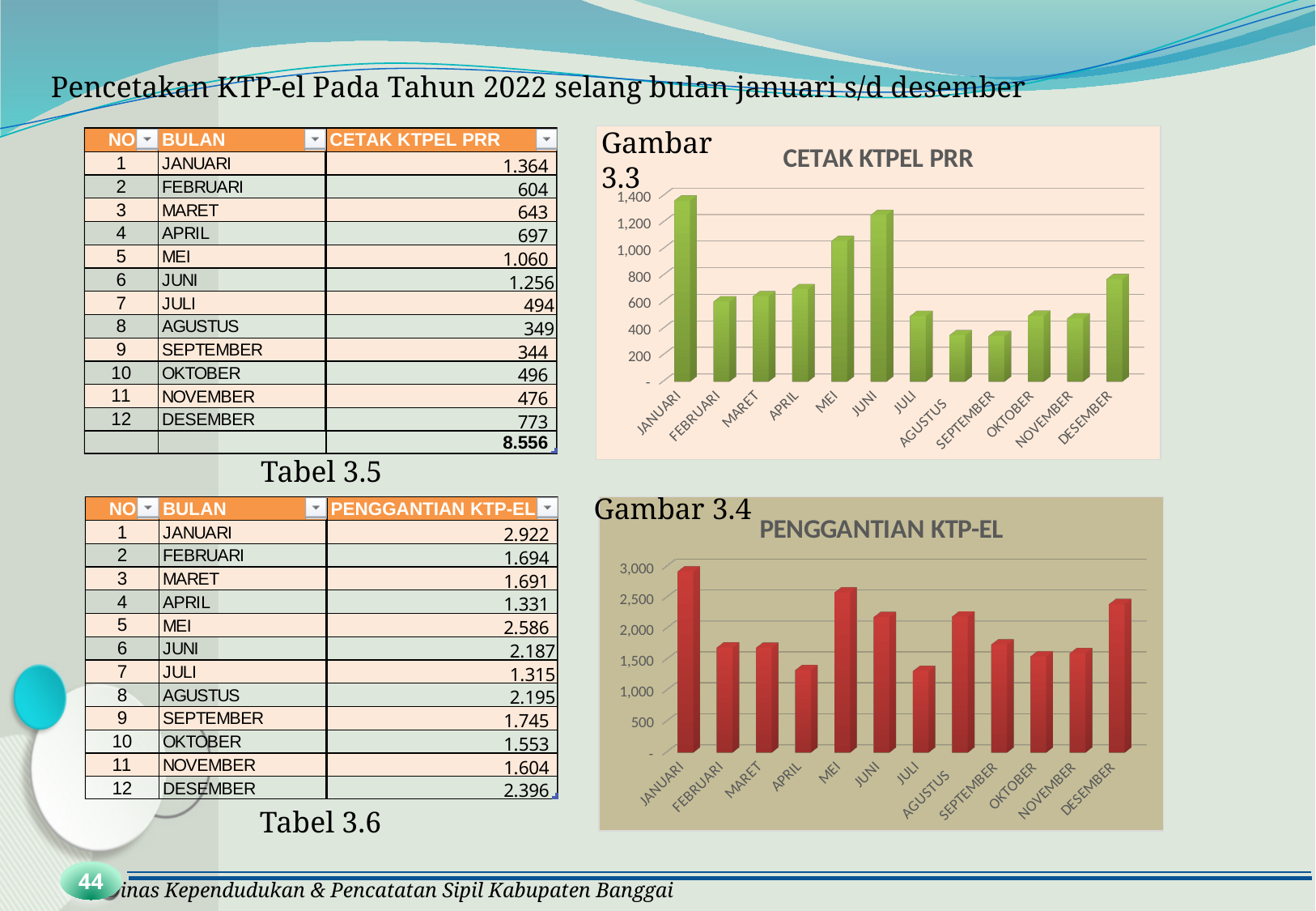
In the PENGGANTIAN KTP-EL chart, which month has the highest value? JANUARI In the CETAK KTPEL PRR chart, is the value for AGUSTUS greater or less than 400? less What kind of chart is the CETAK KTPEL PRR chart (Gambar 3.3)? bar chart In the CETAK KTPEL PRR chart, is the value for JUNI greater or less than 1,200? greater How many months are plotted in the CETAK KTPEL PRR chart? 12 In the PENGGANTIAN KTP-EL chart, is the value for APRIL greater or less than 1,500? less In the CETAK KTPEL PRR chart, which month has the highest value? JANUARI What kind of chart is the PENGGANTIAN KTP-EL chart (Gambar 3.4)? bar chart In the CETAK KTPEL PRR chart, which is larger, the value for MEI or the value for JUNI? JUNI In the PENGGANTIAN KTP-EL chart, do the values rise or fall from JANUARI to APRIL? fall In the CETAK KTPEL PRR chart, do the values rise or fall from JUNI to SEPTEMBER? fall In the PENGGANTIAN KTP-EL chart, which is larger, the value for FEBRUARI or the value for MEI? MEI